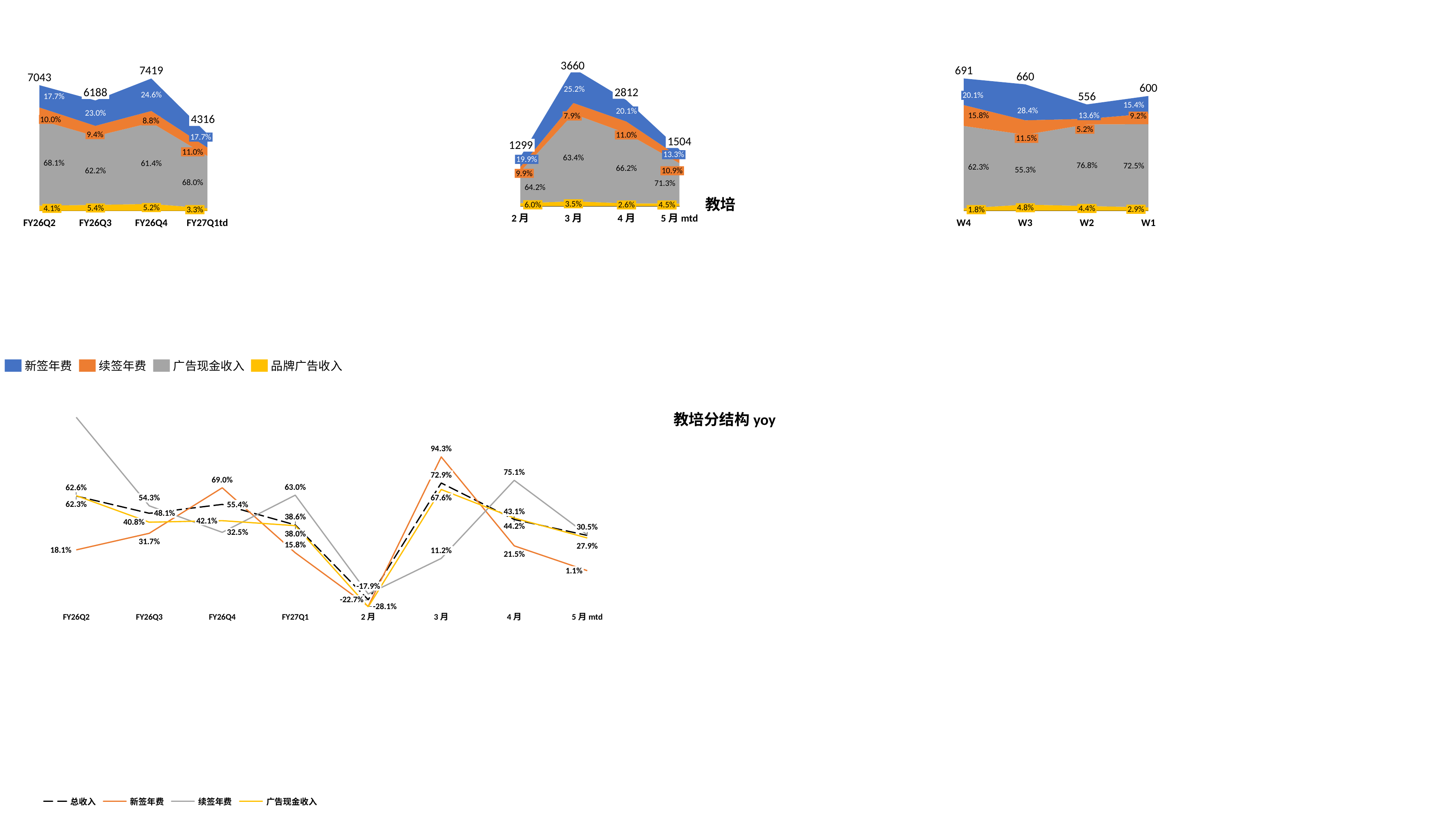
How many series does the legend of the top stacked area charts list? 4 In the bottom chart titled 教培分结构 yoy, what is the value of 续签年费 for 4月? 75.1% In the top-middle chart, what is the difference between the totals for 3月 and 4月? 848 In the top-right chart, which week has the highest total value? W4 In the top-middle chart, what share does 新签年费 have in 5月 mtd? 13.3% In the top-right chart, what share does 续签年费 have in W2? 5.2% In the top-left chart, which period has the lowest total value? FY27Q1td In the top-left chart, what is the total value shown for FY26Q4? 7419 In the top-left chart, what share does 广告现金收入 have in FY26Q2? 68.1% In the top-right chart, is the total for W3 larger or smaller than the total for W1? larger In the top-middle chart, what is the total value for 3月? 3660 In the bottom chart titled 教培分结构 yoy, what is the value of 新签年费 for 3月? 94.3%